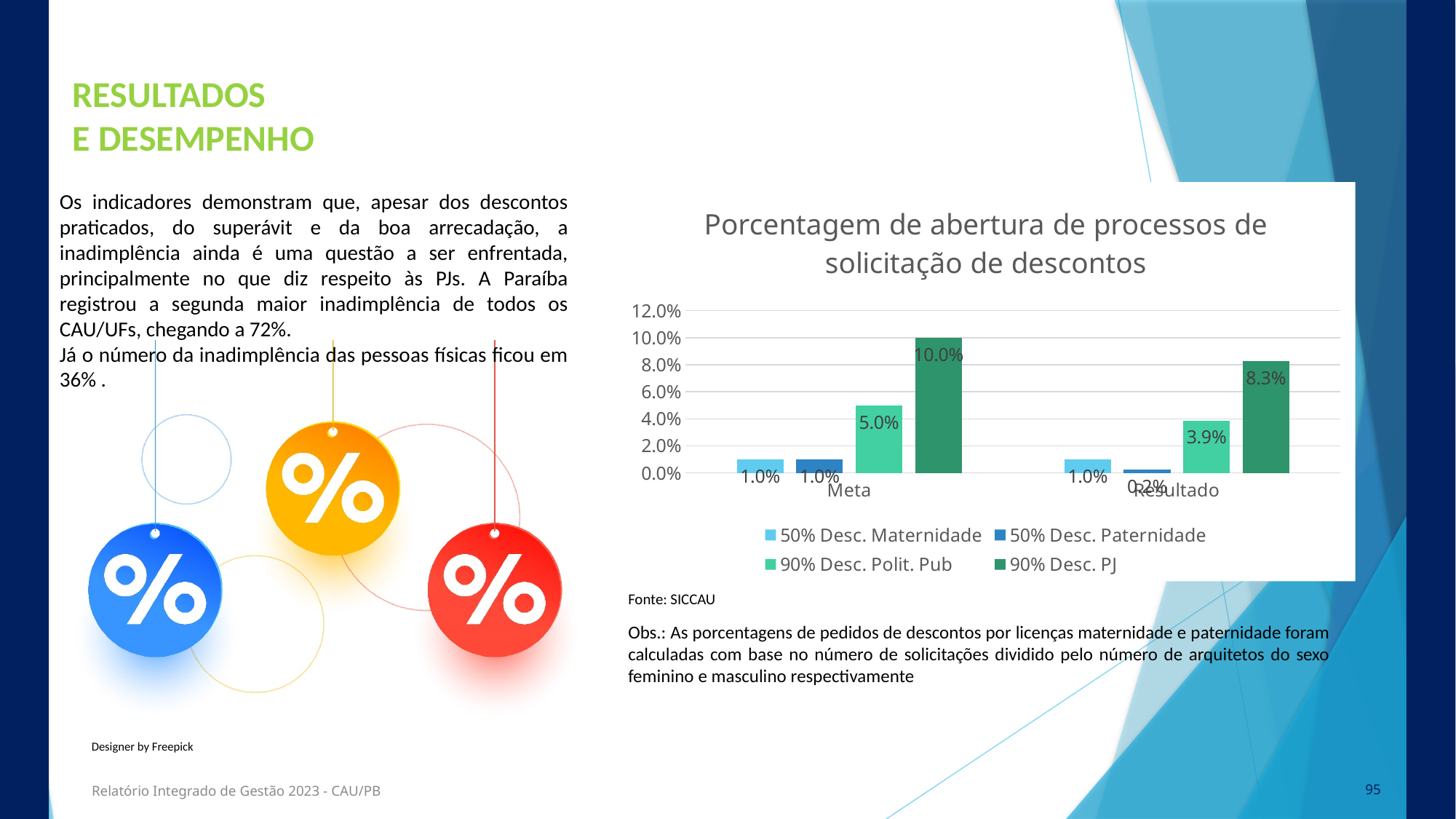
What is the value for 90% Desc. PJ in the Resultado category? 8.3% How many categories are shown on the x axis? 2 Which series has the highest value in the Resultado category? 90% Desc. PJ What is the difference between the Meta and Resultado values for 90% Desc. PJ? 1.7% What is the value for 50% Desc. Maternidade in the Meta category? 1.0% Which series has the lowest value in the Resultado category? 50% Desc. Paternidade What kind of chart is shown on the slide? Bar chart What is the title of the chart? Porcentagem de abertura de processos de solicitação de descontos What is the value for 90% Desc. Polit. Pub in the Resultado category? 3.9% How many series does the legend list? 4 Which is larger: the 90% Desc. Polit. Pub value for Meta or for Resultado? Meta What is the value for 90% Desc. PJ in the Meta category? 10.0%